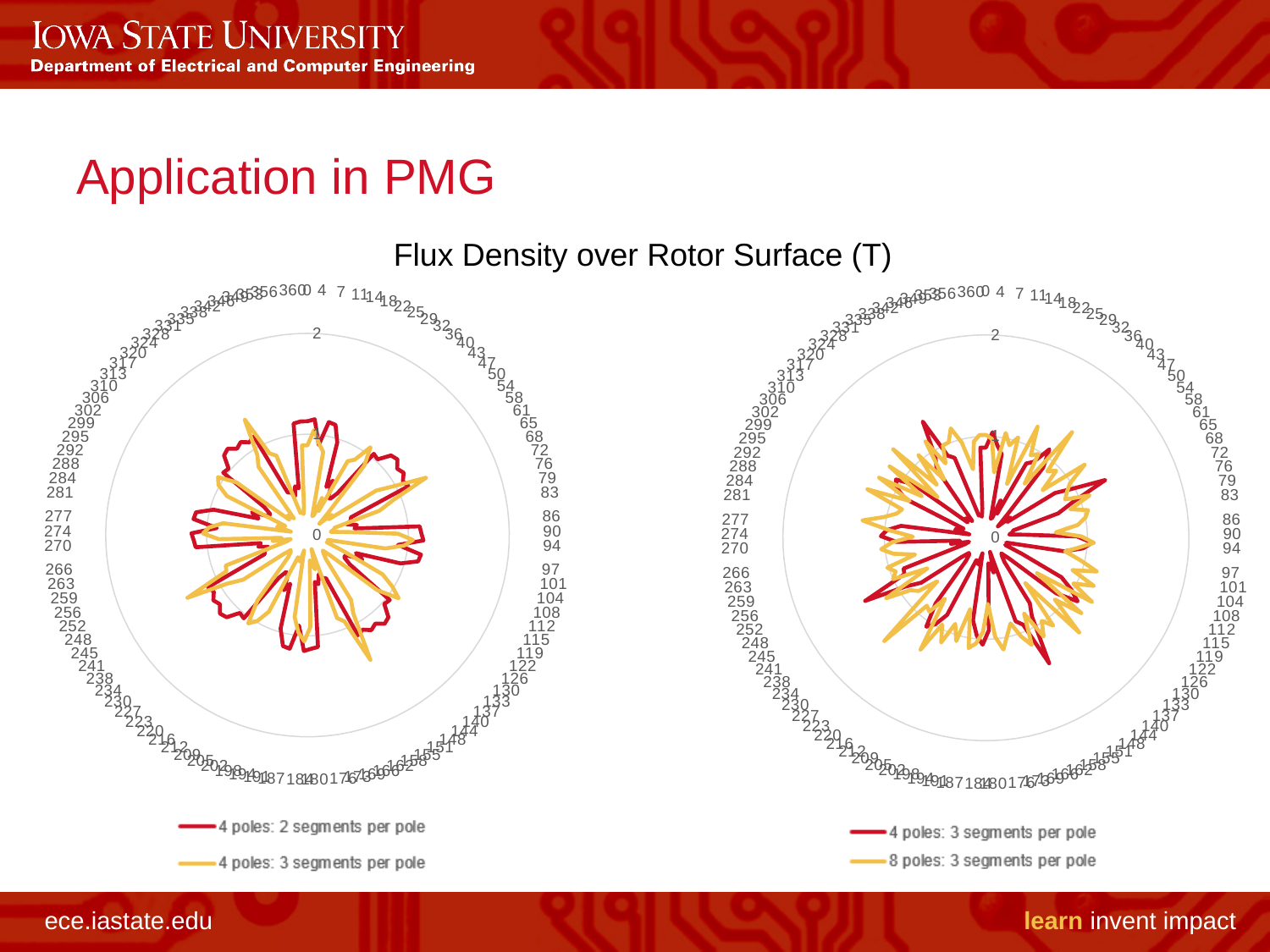
What kind of chart is the right chart on the slide? radar chart In the left chart, is the largest plotted value for the 4 poles: 2 segments per pole series greater or less than 2? less What is the shared title above the two charts? Flux Density over Rotor Surface (T) In the right chart, is the largest plotted value for the 8 poles: 3 segments per pole series greater or less than 2? less What is the highest tick value shown on the radial axis of the left chart? 2 What kind of chart is the left chart on the slide? radar chart How many series does the legend of the left chart list? 2 In the right chart, which series is drawn in red? 4 poles: 3 segments per pole How many series does the legend of the right chart list? 2